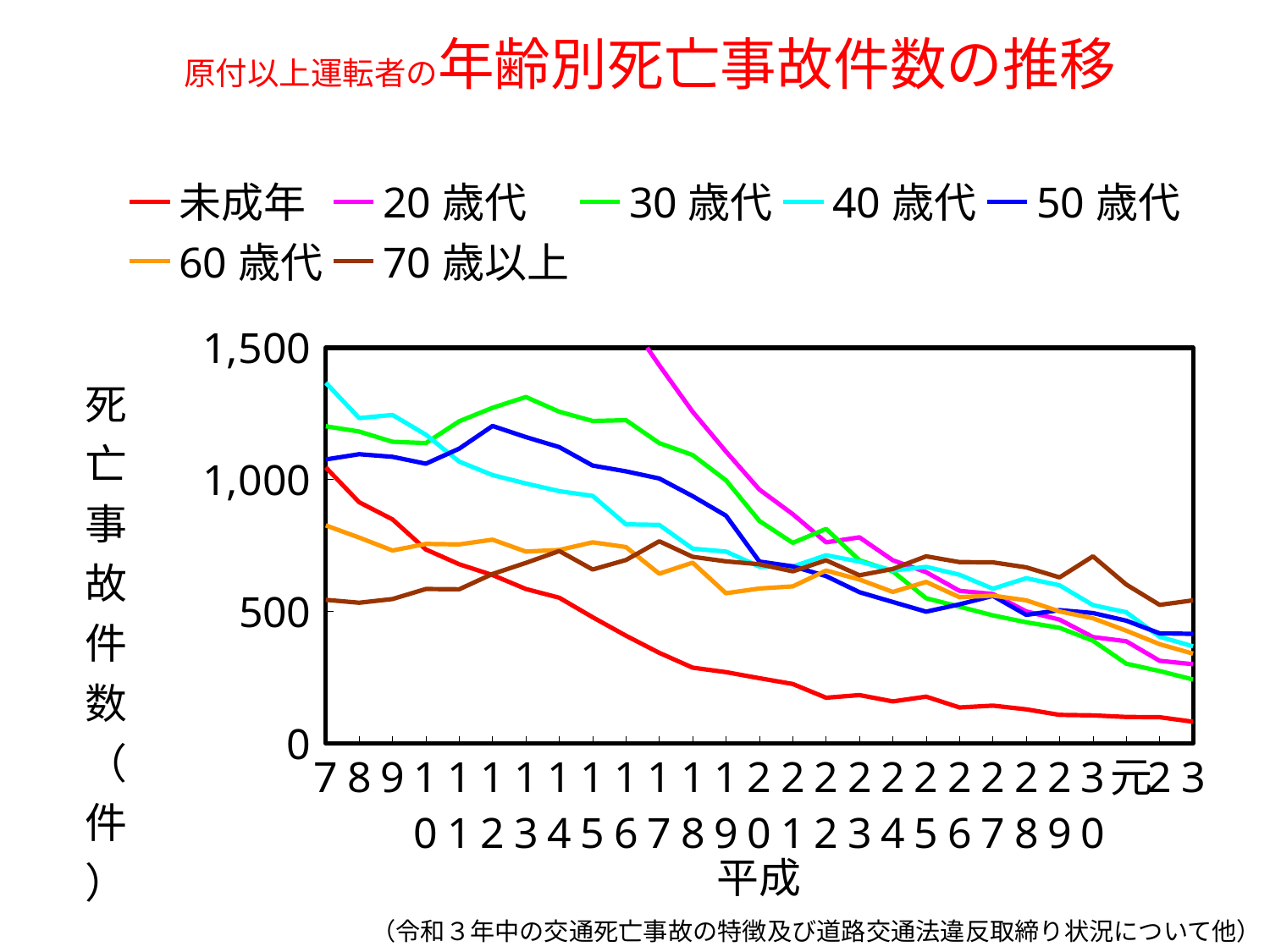
Which series has the lowest value in 令和3? 未成年 Is the value for 未成年 in 令和3 greater or less than 500? less What kind of chart is shown on the slide? line chart Is the value for 50歳代 in 平成12 greater or less than 1,000? greater Does the value for 未成年 rise or fall from 平成7 to 令和3? fall What is the title of the chart? 原付以上運転者の年齢別死亡事故件数の推移 Is the value for 40歳代 in 平成7 greater or less than 1,000? greater In 令和3, which is larger: the value for 70歳以上 or the value for 未成年? 70歳以上 How many series does the legend list? 7 Which series is drawn in red according to the legend? 未成年 In 平成7, which is larger: the value for 40歳代 or the value for 未成年? 40歳代